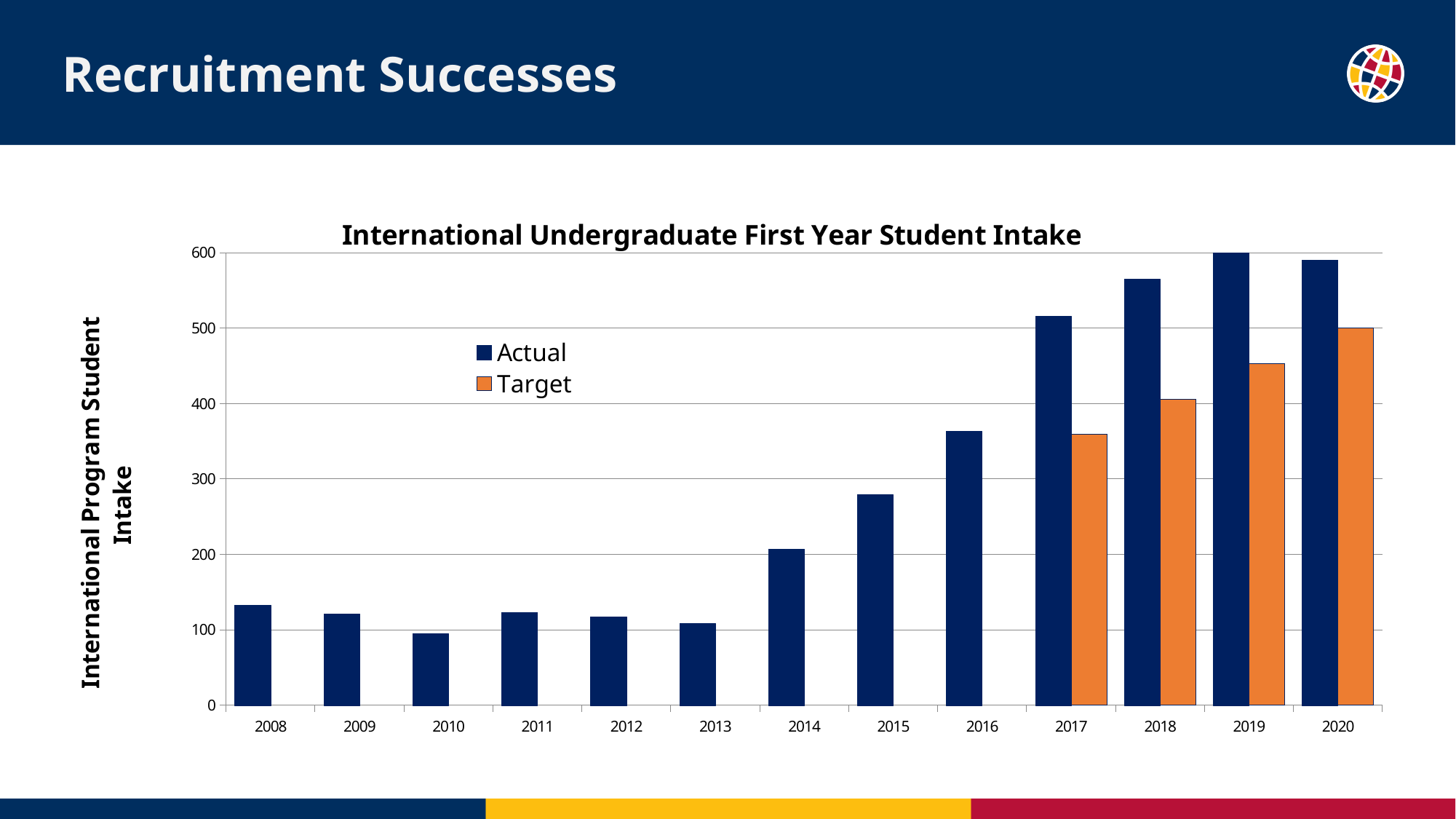
Do the Actual values rise or fall from 2013 to 2019? rise What kind of chart is shown on the slide? bar chart How many series does the legend list? 2 How many years are shown on the x axis? 13 Is the Target value for 2017 greater or less than 400? less What is the title of the chart? International Undergraduate First Year Student Intake Is the Actual value for 2016 greater or less than 300? greater Which year has the lowest Actual intake? 2010 In how many years is a Target bar shown? 4 In 2017, which is larger, the Actual or the Target value? Actual